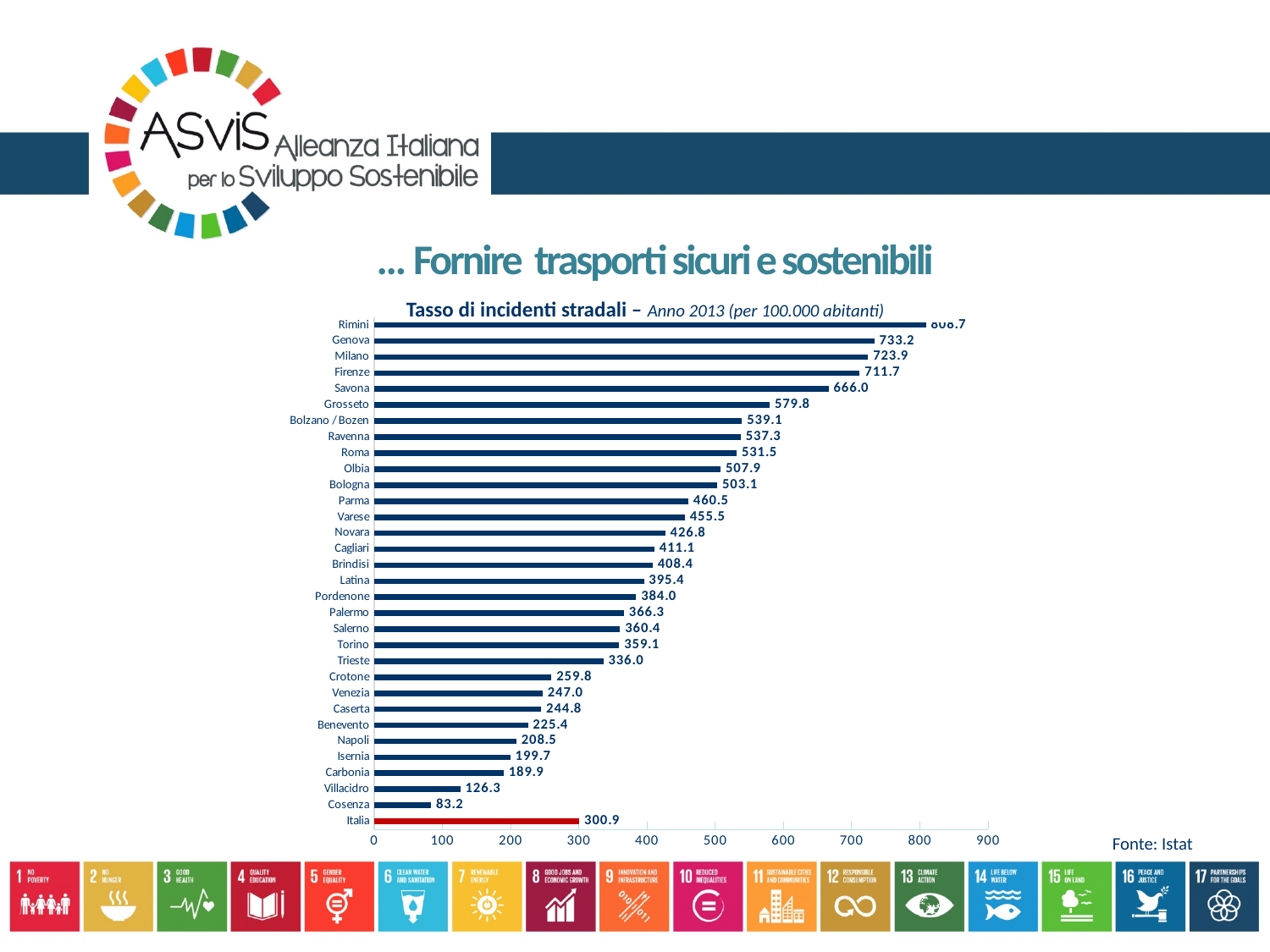
What is the difference between the values for Roma and Italia? 230.6 Which category has the lowest value? Cosenza What is the value for Italia? 300.9 Is the value for Rimini greater or less than 800? greater What is the value for Napoli? 208.5 Which bar is shown in red rather than blue? Italia How many categories are shown in the chart? 32 What is the value for Genova? 733.2 What is the difference between the values for Genova and Milano? 9.3 Which category has the highest value? Rimini What kind of chart is this? Bar chart Which is larger, the value for Palermo or the value for Napoli? Palermo